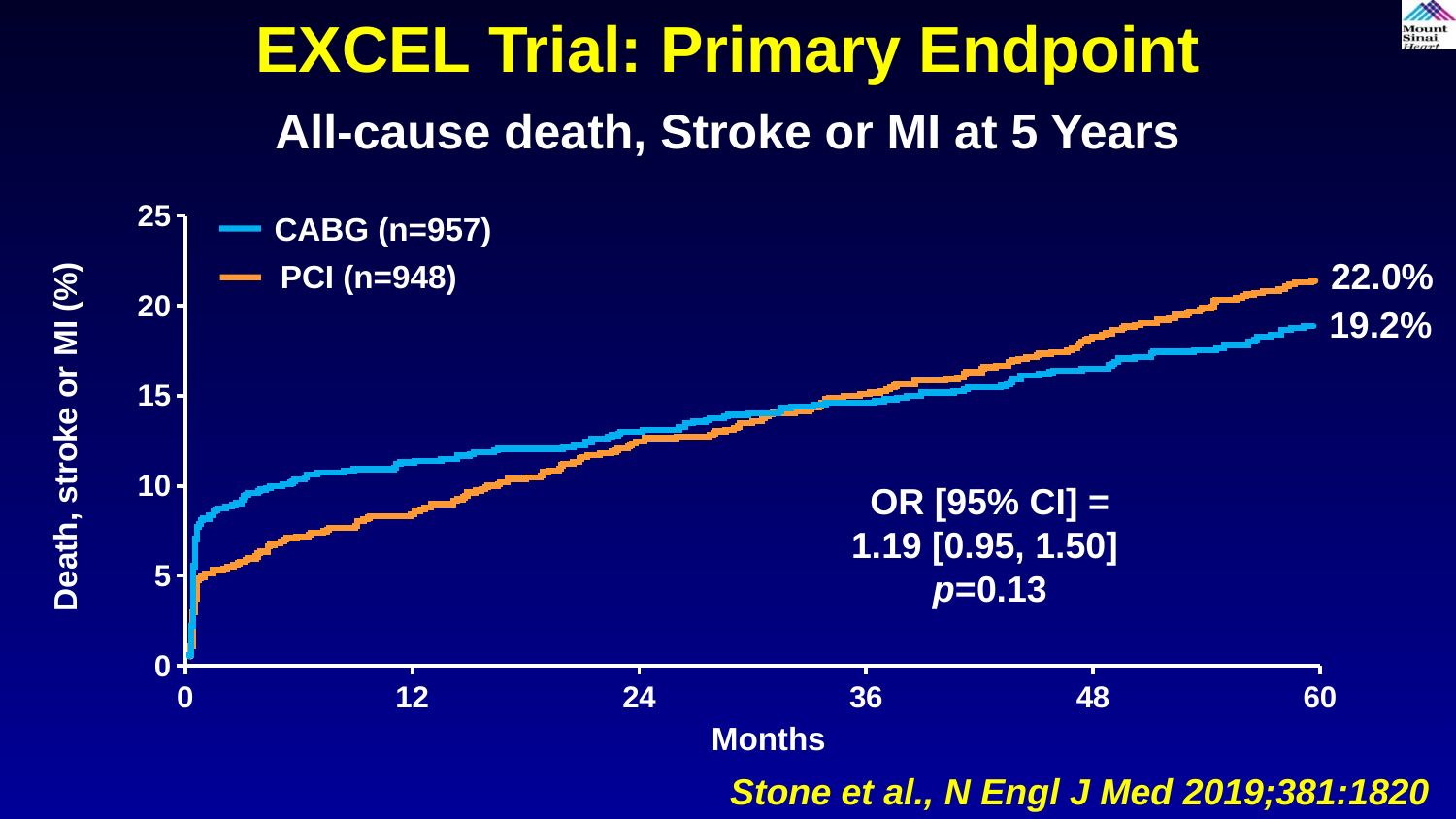
What is the difference between the PCI and CABG values at 60 months? 2.8% Is the value for PCI at 12 months greater or less than 10? less Is the value for CABG at 12 months greater or less than 10? greater Which series has the higher value at 60 months, CABG or PCI? PCI What is the label of the y axis? Death, stroke or MI (%) How many series does the legend list? 2 Do the values for PCI rise or fall as months increase? Rise What kind of chart is shown on the slide? Line chart What is the value for PCI at 60 months? 22.0% Is the value for PCI at 48 months greater or less than 15? greater Which series has the higher value at 12 months, CABG or PCI? CABG What is the value for CABG at 60 months? 19.2%